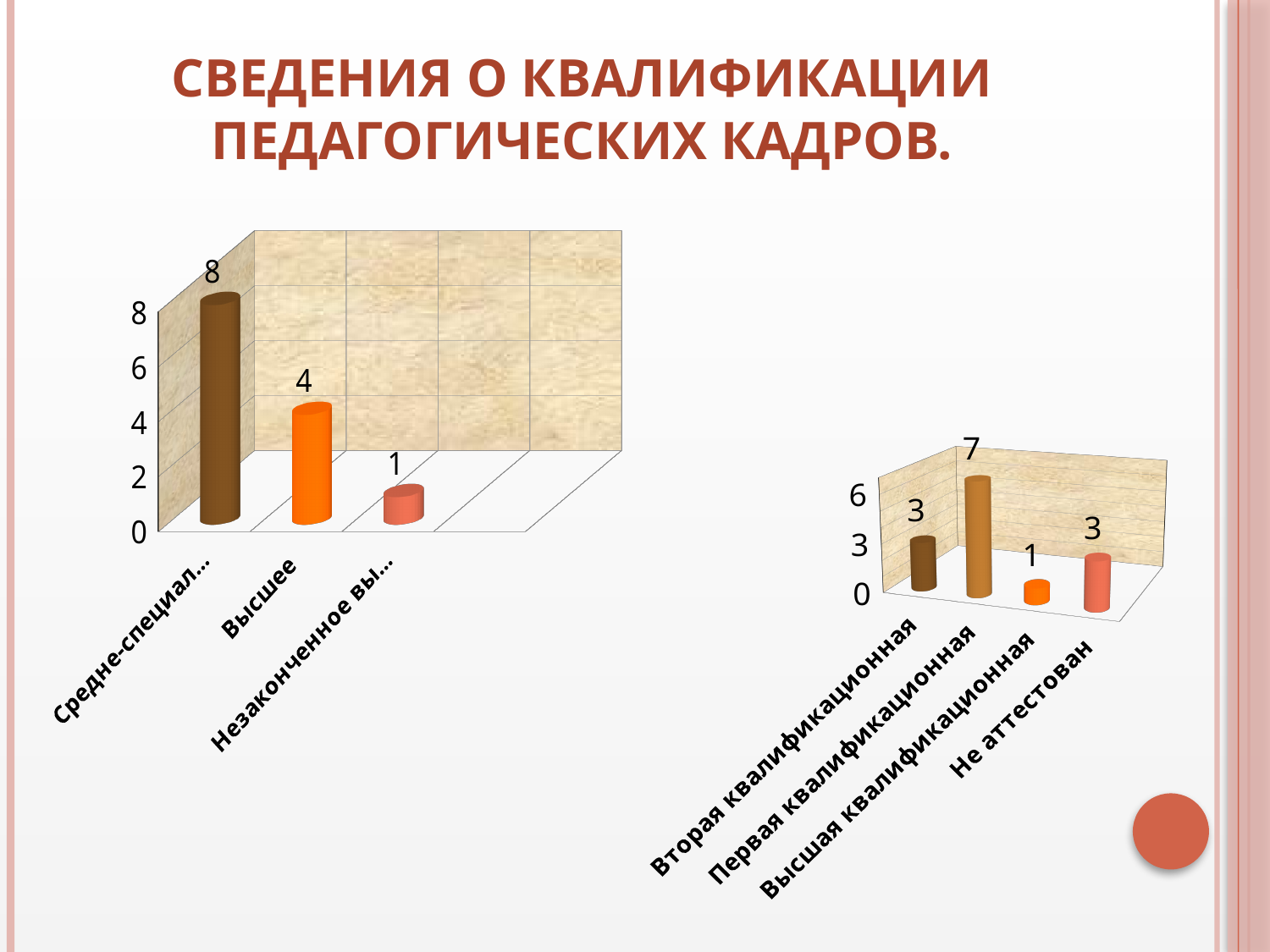
On the right chart, what is the value for Первая квалификационная? 7 On the left chart, which category has the highest value? Средне-специал... On the left chart, what is the value for Высшее? 4 How many bars are on the left chart? 3 On the right chart, what is the value for Не аттестован? 3 What type of chart is the right chart? Bar chart On the right chart, which category has the lowest value? Высшая квалификационная On the right chart, which category has the highest value? Первая квалификационная On the right chart, what is the difference between Первая квалификационная and Вторая квалификационная? 4 On the left chart, what is the difference between the first bar (8) and Высшее? 4 On the left chart, what is the value of the tallest bar? 8 How many categories are on the right chart? 4